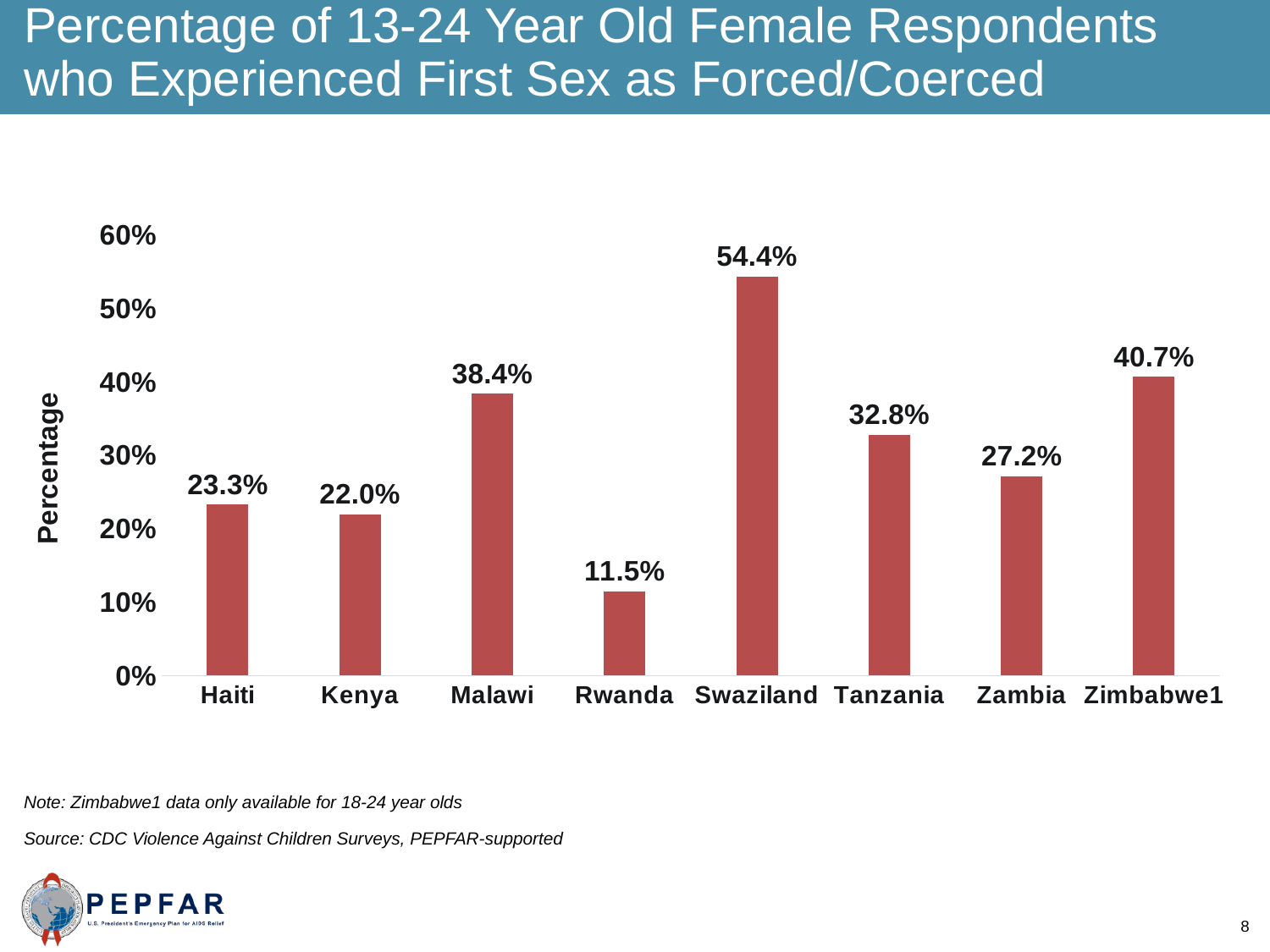
What is the difference between the values for Swaziland and Rwanda? 42.9% What is the label on the vertical axis? Percentage What is the value for Swaziland? 54.4% What is the difference between the values for Malawi and Tanzania? 5.6% Is the value for Malawi greater or less than 30%? greater What is the value for Zimbabwe1? 40.7% What kind of chart is shown on the slide? Bar chart Which is larger, the value for Haiti or the value for Zambia? Zambia Which country has the lowest value? Rwanda What is the value for Rwanda? 11.5% Which country has the highest value? Swaziland How many countries are shown on the chart? 8